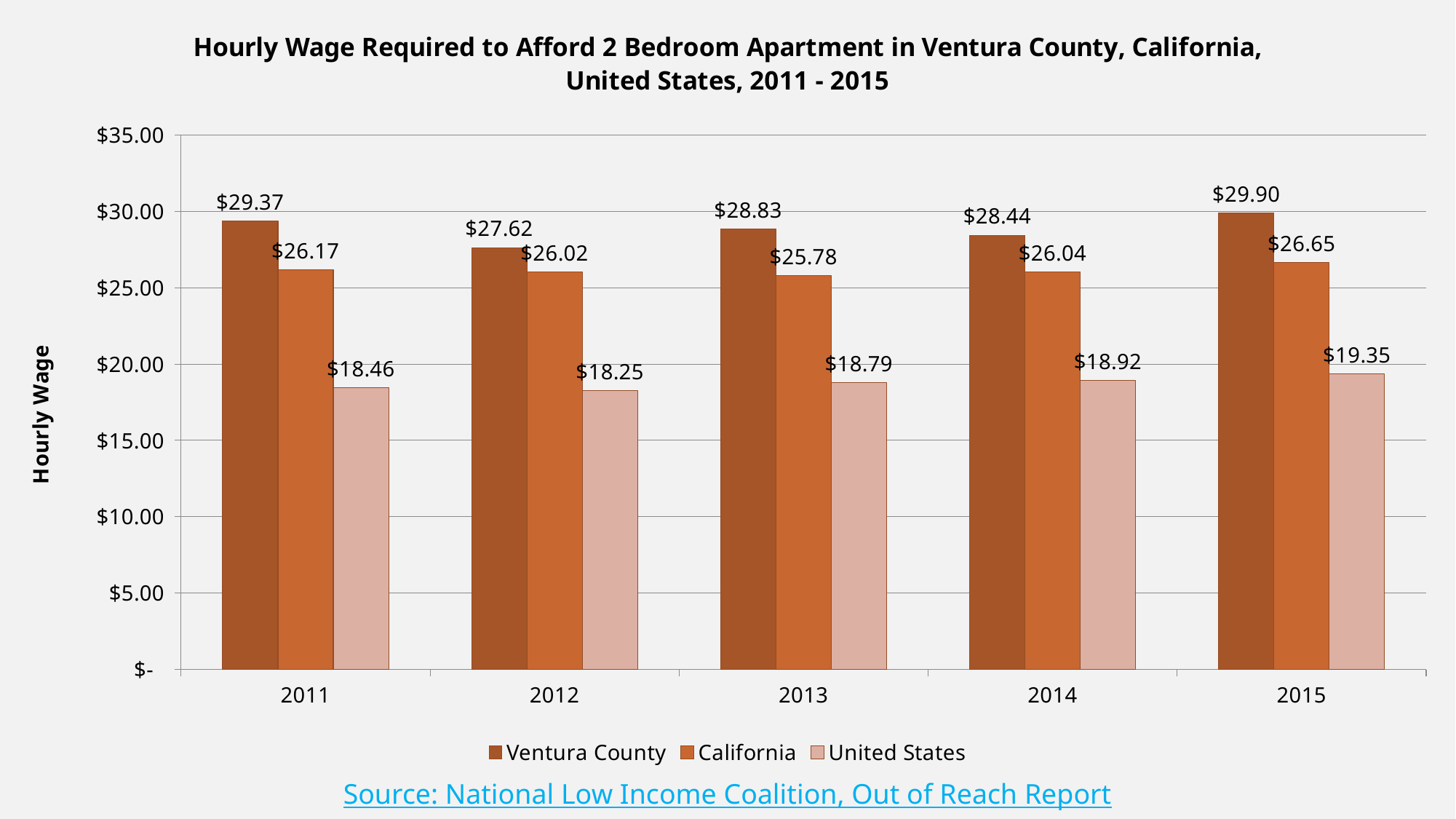
What is the label on the vertical axis? Hourly Wage In which year is the United States hourly wage the lowest? 2012 Is the value for California in 2015 greater or less than $25.00? greater What is the hourly wage required for Ventura County in 2011? $29.37 What is the difference between the Ventura County and United States hourly wages in 2014? $9.52 What kind of chart is shown on the slide? Bar chart In which year is the Ventura County hourly wage the highest? 2015 What is the hourly wage required for California in 2013? $25.78 How many years are shown on the x axis? 5 What is the hourly wage required for the United States in 2015? $19.35 Which is larger in 2012: the Ventura County wage or the California wage? Ventura County How many series does the legend list? 3